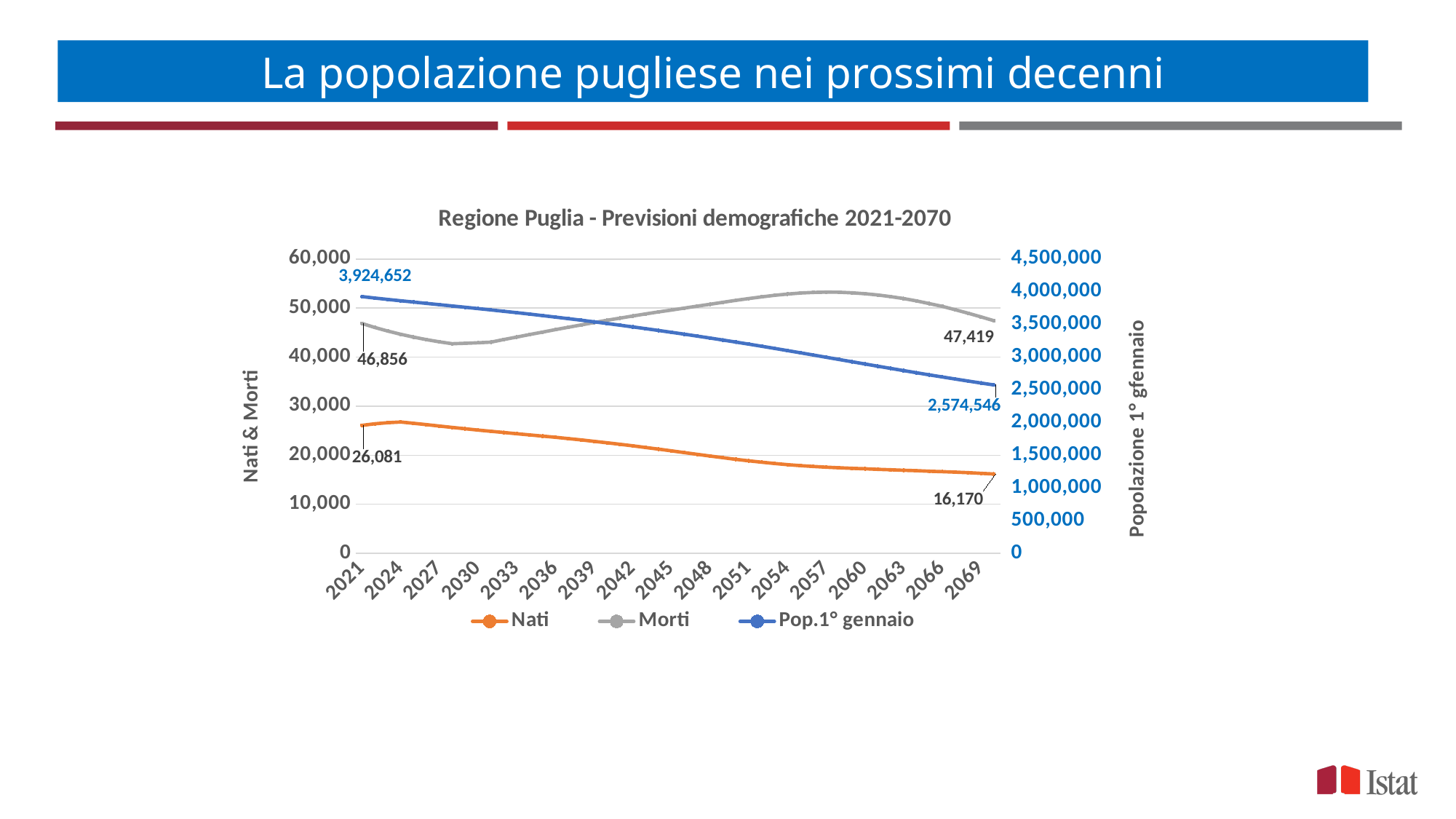
What is the value of Pop.1° gennaio at the end of the series? 2,574,546 What kind of chart is shown on the slide? line chart By how much does Nati decrease from 2021 to the end of the series? 9,911 What is the value of Nati in 2021? 26,081 What is the value of Morti in 2021? 46,856 What is the value of Pop.1° gennaio in 2021? 3,924,652 How many series does the legend list? 3 What is the value of Nati at the end of the series? 16,170 Does the Pop.1° gennaio series rise or fall over the period shown? fall What is the value of Morti at the end of the series? 47,419 By how much does Pop.1° gennaio decrease from 2021 to the end of the series? 1,350,106 Is the value for Morti in 2057 greater or less than 50,000? greater